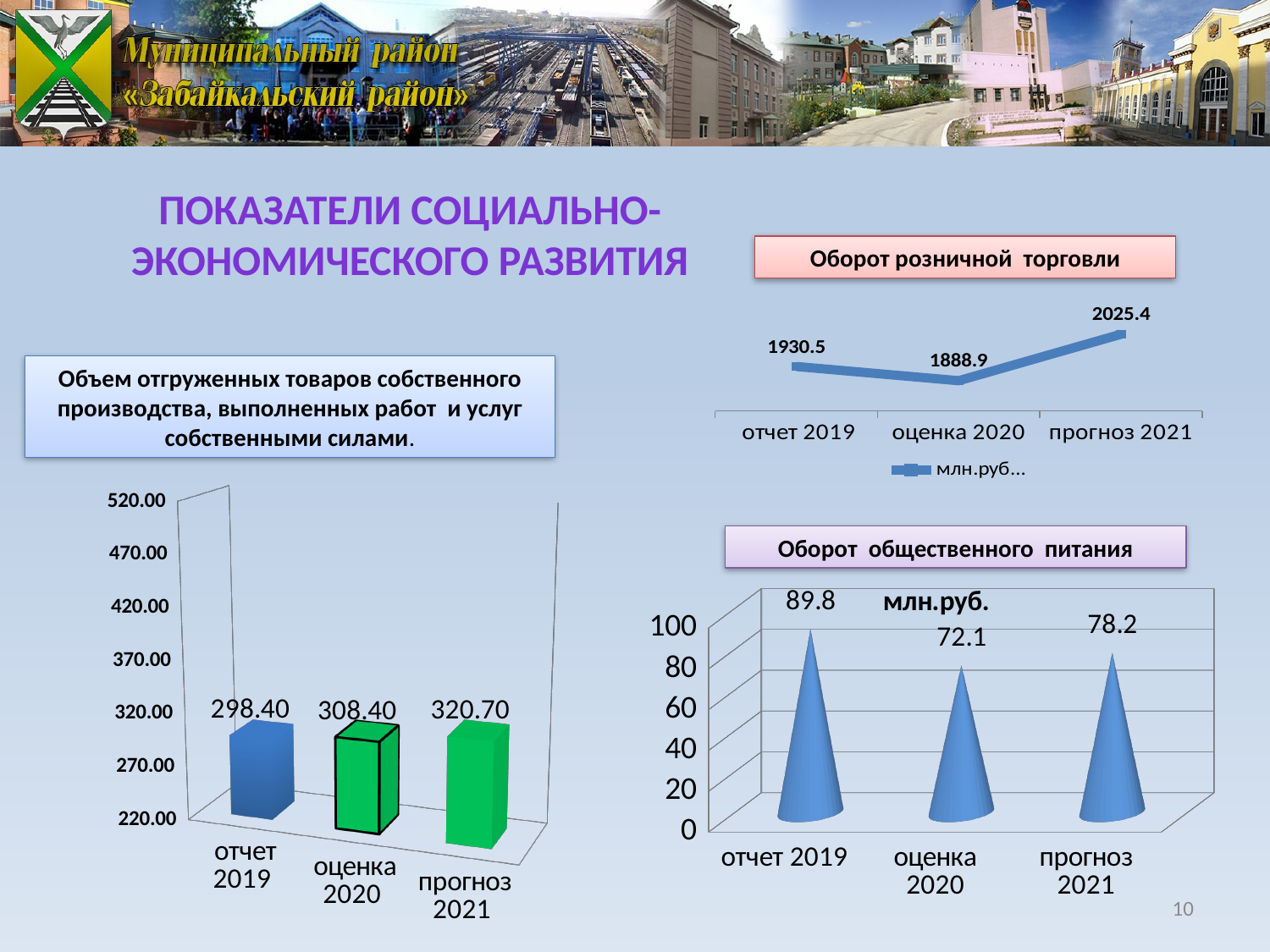
In the chart 'Оборот общественного питания', which is larger: 'оценка 2020' or 'прогноз 2021'? прогноз 2021 In the chart 'Оборот розничной торговли', which category has the lowest value? оценка 2020 What kind of chart is 'Оборот розничной торговли'? line chart In the chart 'Объем отгруженных товаров собственного производства...', what is the difference between 'прогноз 2021' and 'отчет 2019'? 22.30 What kind of chart is 'Объем отгруженных товаров собственного производства...'? bar chart In the chart 'Объем отгруженных товаров собственного производства...', do the values rise or fall from 'отчет 2019' to 'прогноз 2021'? rise In the chart 'Объем отгруженных товаров собственного производства, выполненных работ и услуг собственными силами', what is the value for 'оценка 2020'? 308.40 How many categories are shown in the chart 'Оборот общественного питания'? 3 In the chart 'Объем отгруженных товаров собственного производства...', which category has the highest value? прогноз 2021 In the chart 'Оборот общественного питания', what is the value for 'отчет 2019'? 89.8 In the chart 'Оборот розничной торговли', what is the value for 'оценка 2020'? 1888.9 In the chart 'Оборот розничной торговли', what is the difference between 'прогноз 2021' and 'отчет 2019'? 94.9